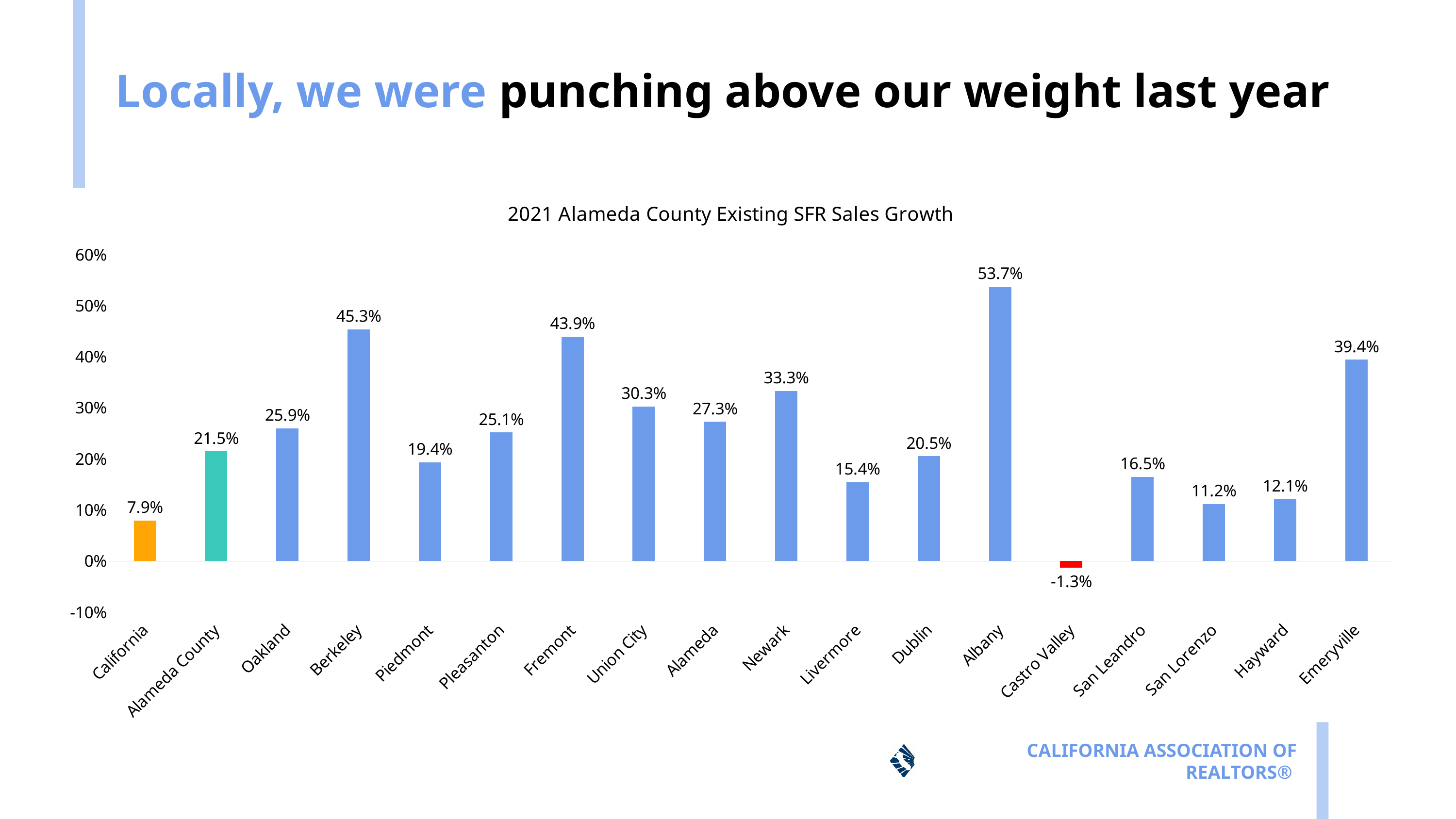
What is the 2021 existing SFR sales growth for Albany? 53.7% What is the difference between the sales growth for Berkeley and Fremont? 1.4% How many categories are shown on the x axis? 18 Which category has the highest sales growth? Albany Is the value for Emeryville greater or less than 30%? greater What kind of chart is shown on the slide? Bar chart What colour is the bar for Alameda County? Green (teal) Which has higher sales growth, Oakland or Union City? Union City What is the sales growth value shown for California? 7.9% What is the title of the chart? 2021 Alameda County Existing SFR Sales Growth Which category has the lowest sales growth? Castro Valley What is the sales growth value shown for Castro Valley? -1.3%